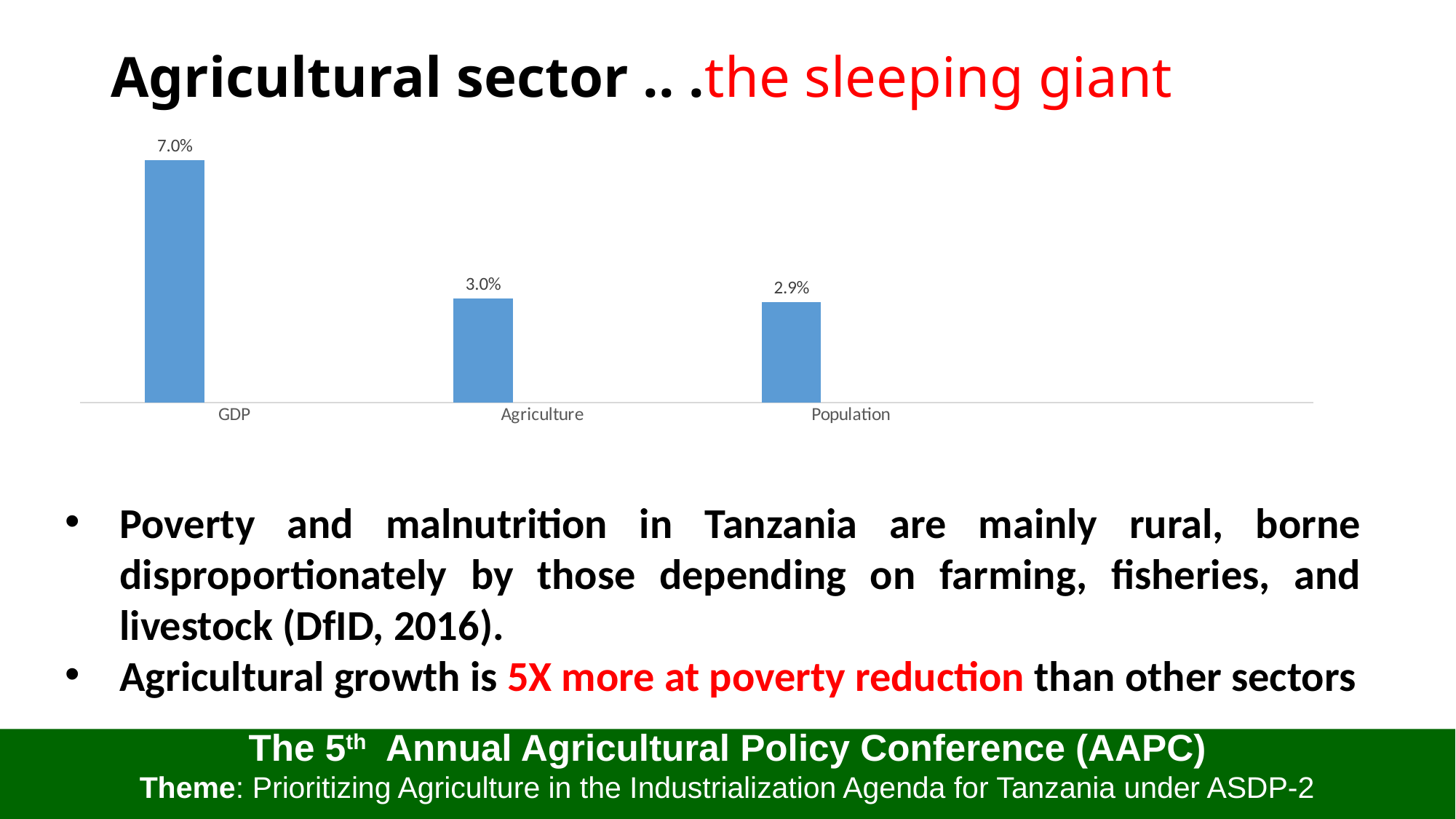
What colour are the bars in the chart? Blue What is the difference between the GDP value and the Agriculture value? 4.0% Do the values rise or fall from GDP to Population along the x axis? Fall Which category has the highest value? GDP What is the value shown for Agriculture? 3.0% What is the value shown for GDP? 7.0% What is the label of the first category on the x axis? GDP How many categories are shown in the chart? 3 What kind of chart is shown on the slide? Bar chart What is the difference between the Agriculture value and the Population value? 0.1% What is the value shown for Population? 2.9% Which is larger, the value for GDP or the value for Population? GDP